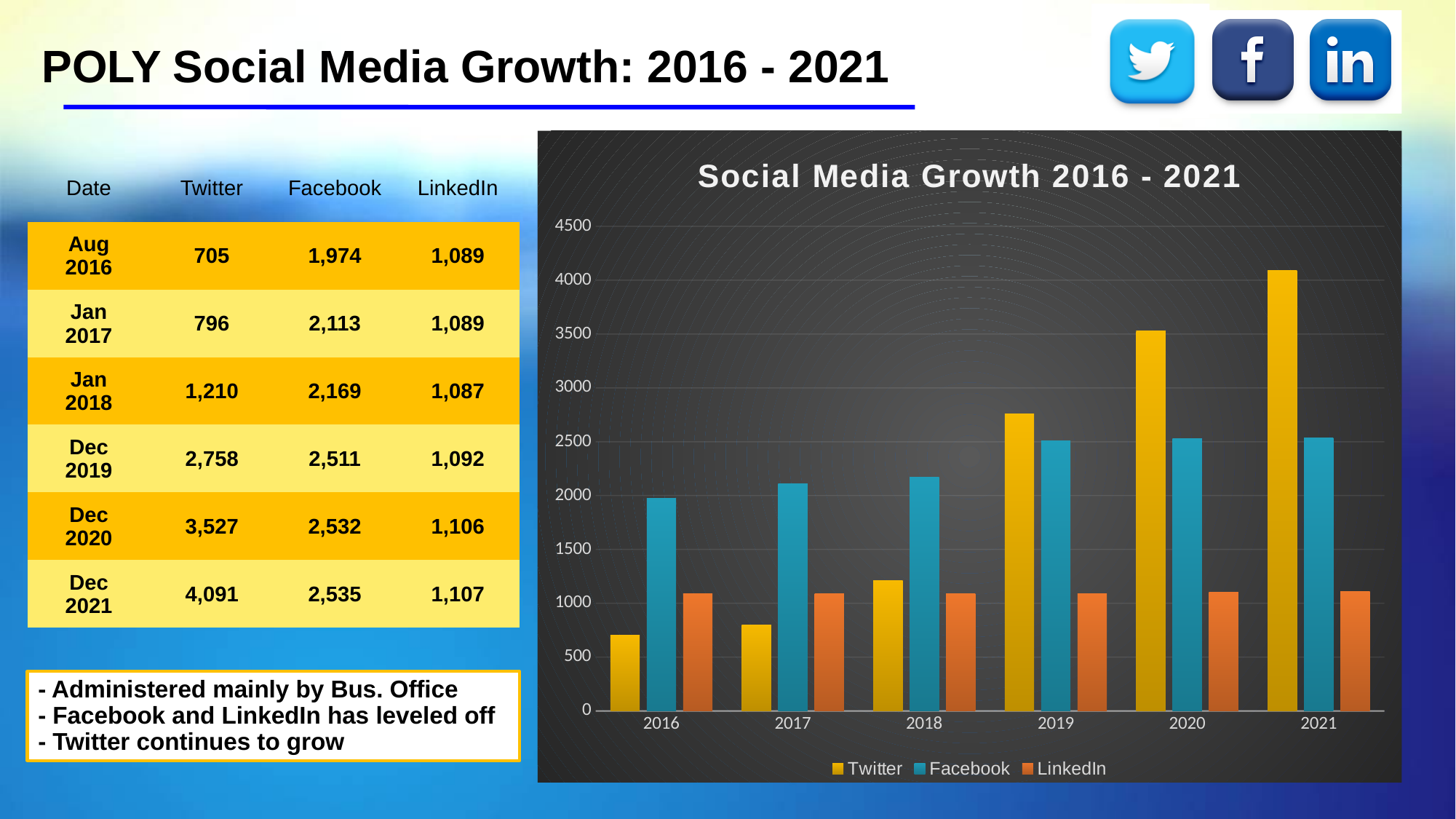
How many series does the chart legend list? 3 Is the Facebook value for 2016 greater or less than 2000? less Is the LinkedIn value for 2019 greater or less than 1500? less According to the table on the slide, what is the Twitter value for Dec 2021? 4,091 Which series has the shortest bar in 2016? Twitter How many years are shown along the x axis of the chart? 6 Which series has the tallest bar in 2021? Twitter Is the Twitter value for 2021 greater or less than 4000? greater In 2018, which is larger, the Facebook bar or the Twitter bar? Facebook What kind of chart is shown on the slide? bar chart Do the Twitter values rise or fall from 2016 to 2021? rise What is the title of the chart? Social Media Growth 2016 - 2021